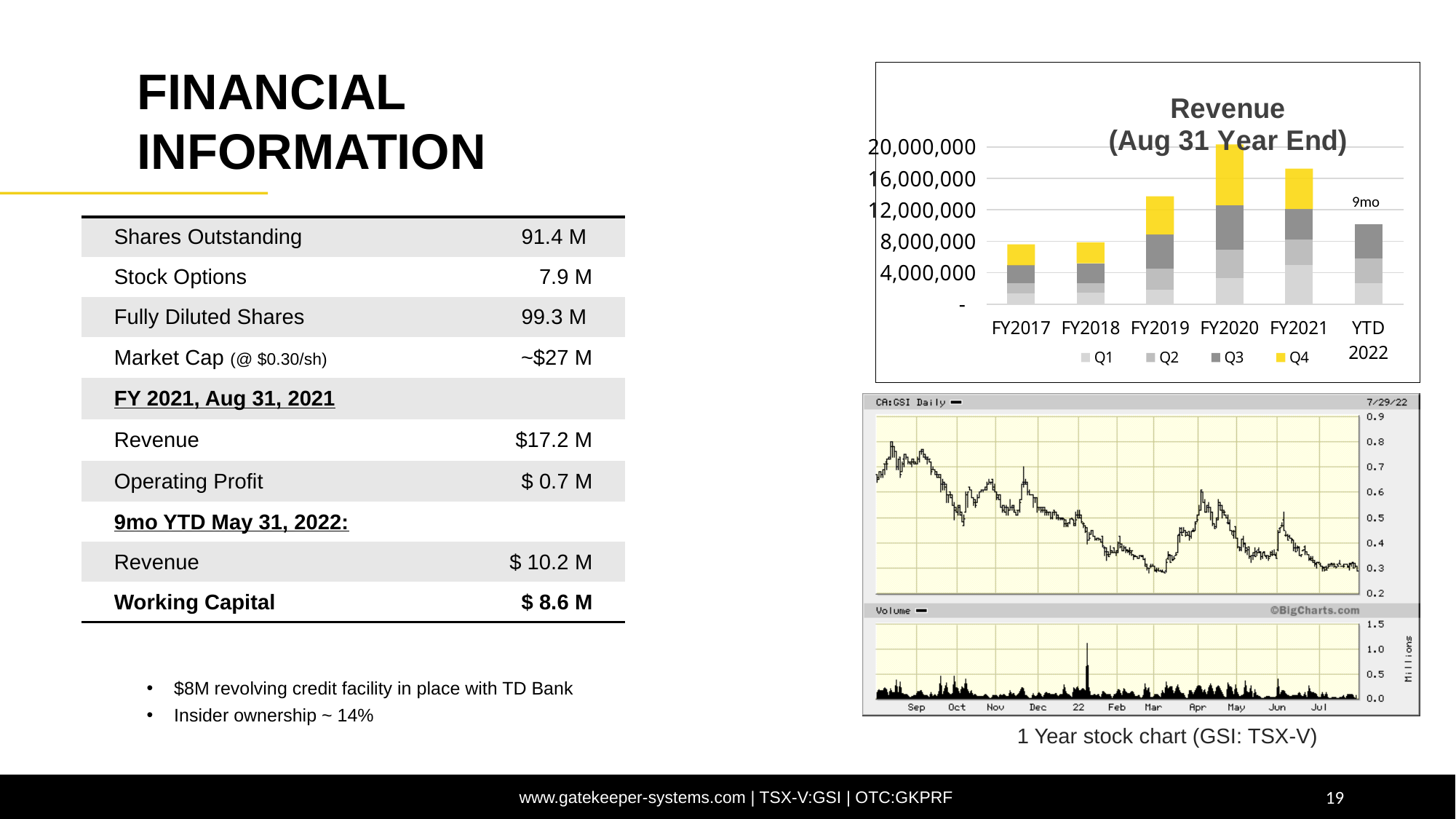
How many categories are shown on the x axis of the Revenue (Aug 31 Year End) chart? 6 In the Revenue (Aug 31 Year End) chart, is the total revenue for YTD 2022 greater or less than 12,000,000? less In the Revenue (Aug 31 Year End) chart, is the total revenue for FY2017 greater or less than 8,000,000? less What type of chart is the Revenue (Aug 31 Year End) chart? stacked bar chart How many series does the legend of the Revenue (Aug 31 Year End) chart list? 4 In the Revenue (Aug 31 Year End) chart, does total revenue rise or fall from FY2017 to FY2020? rise In the Revenue (Aug 31 Year End) chart, is the total revenue for FY2020 greater or less than 16,000,000? greater In the Revenue (Aug 31 Year End) chart, which quarter is shown in yellow? Q4 In the 1 Year stock chart (GSI: TSX-V), does the share price generally rise or fall from Sep to Jul? fall What type of chart is the 1 Year stock chart (GSI: TSX-V) price panel? line chart In the Revenue (Aug 31 Year End) chart, which is larger, the total revenue for FY2020 or FY2021? FY2020 In the Revenue (Aug 31 Year End) chart, which fiscal year has the highest total revenue? FY2020